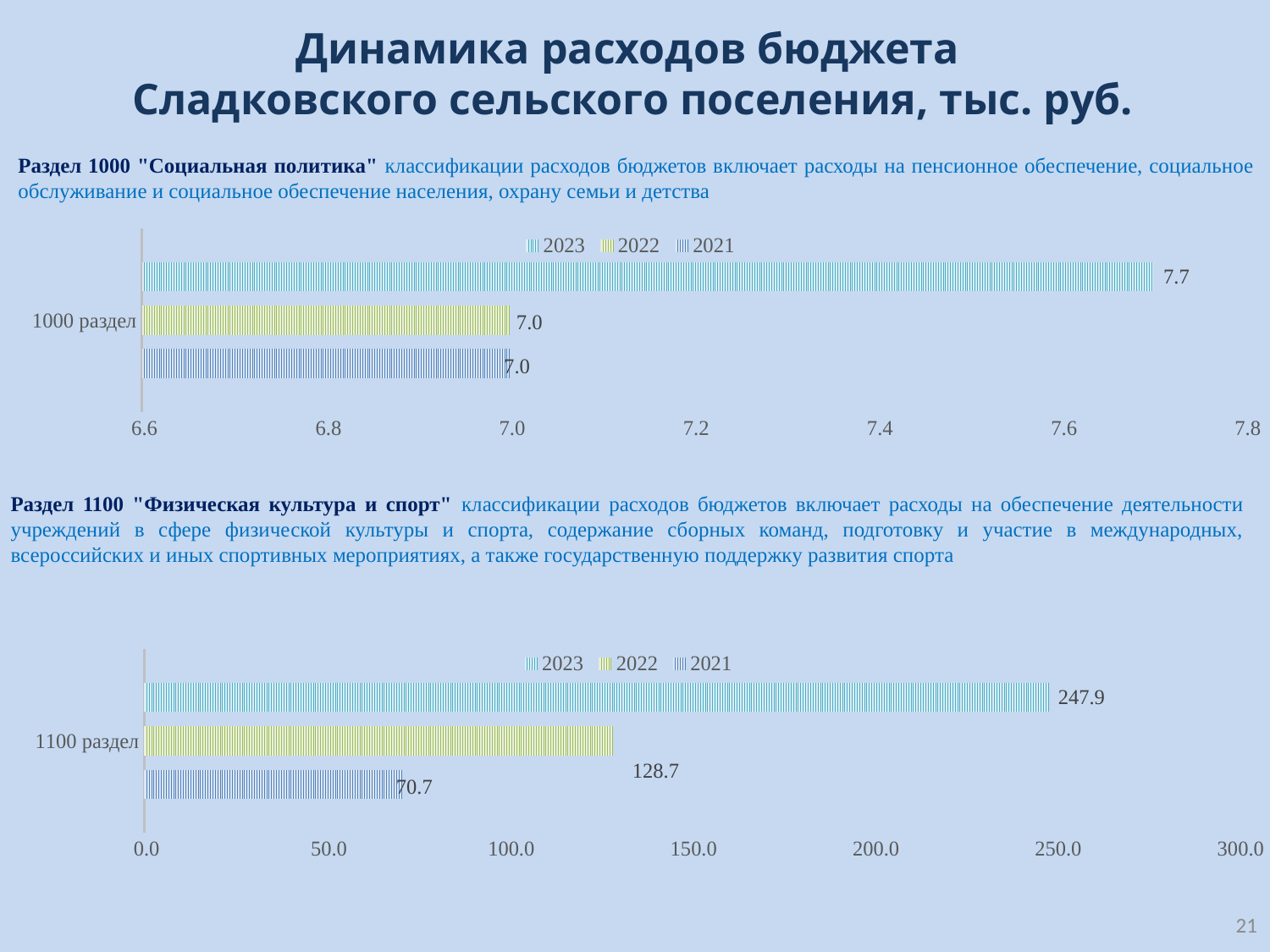
In the bottom chart (1100 раздел), which year has the lowest value? 2021 In the bottom chart (1100 раздел), which year has the highest value? 2023 In the bottom chart (1100 раздел), is the value for 2022 greater or less than 100.0? greater In the top chart (1000 раздел), what is the value for 2023? 7.7 How many series does the legend of the bottom chart list? 3 In the top chart (1000 раздел), what is the difference between the 2023 and 2021 values? 0.7 In the top chart (1000 раздел), what is the value for 2022? 7.0 In the bottom chart (1100 раздел), which is larger, the value for 2022 or the value for 2021? 2022 In the bottom chart (1100 раздел), what is the difference between the 2023 and 2022 values? 119.2 In the bottom chart (1100 раздел), what is the value for 2023? 247.9 What kind of chart is the top chart? Bar chart In the bottom chart (1100 раздел), what is the value for 2021? 70.7